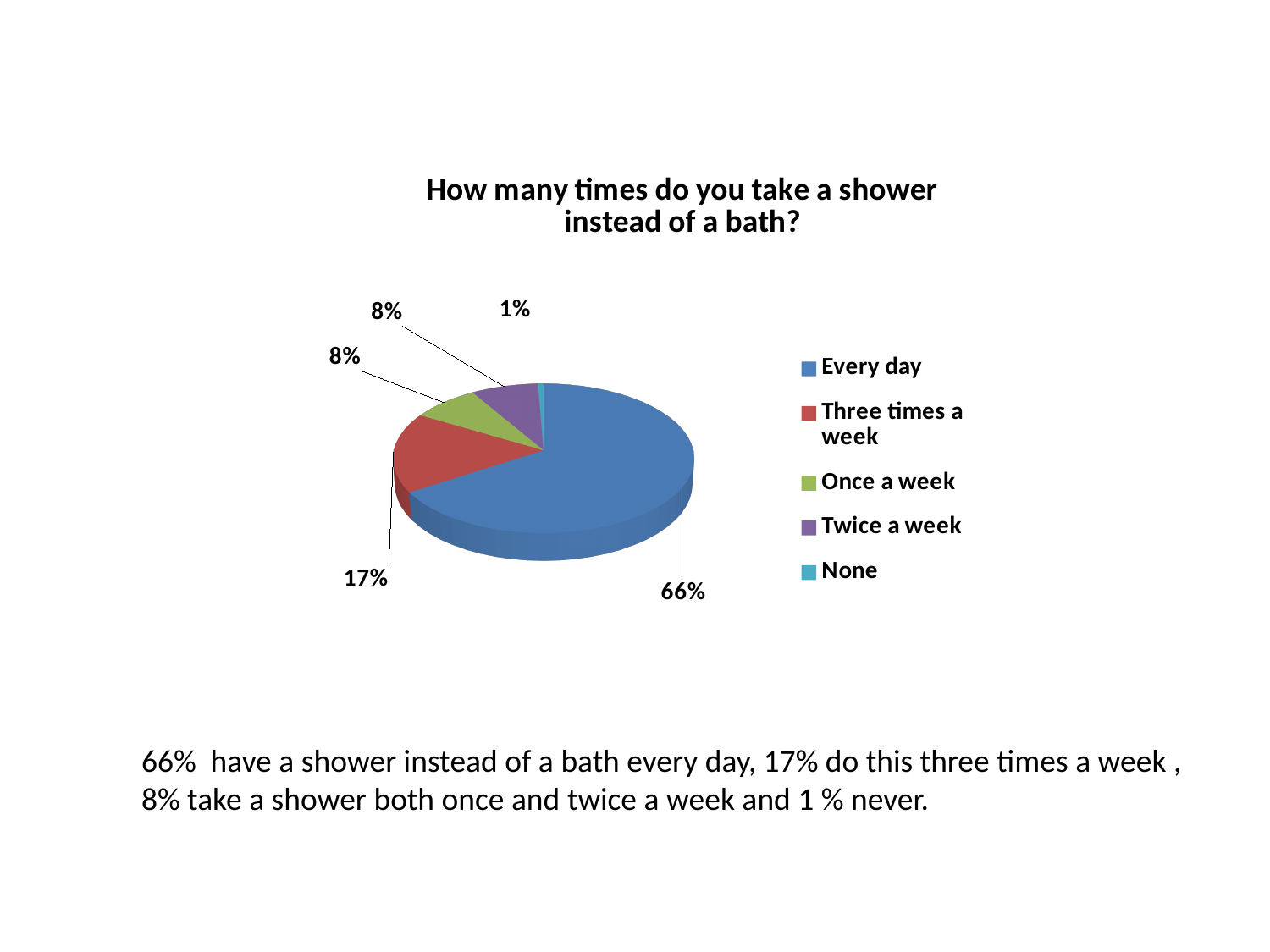
What is the difference between the 'Every day' share and the 'Three times a week' share? 49% Which is larger, the 'Three times a week' slice or the 'Once a week' slice? Three times a week Which category has the smallest slice? None Which category has the largest slice? Every day What share of the pie is 'None'? 1% What kind of chart is shown on the slide? pie chart What share of the pie is 'Three times a week'? 17% What colour is the 'Every day' slice? blue What is the difference between the 'Once a week' share and the 'None' share? 7% How many categories does the legend list? 5 What share of the pie is 'Every day'? 66% What is the title of the chart? How many times do you take a shower instead of a bath?